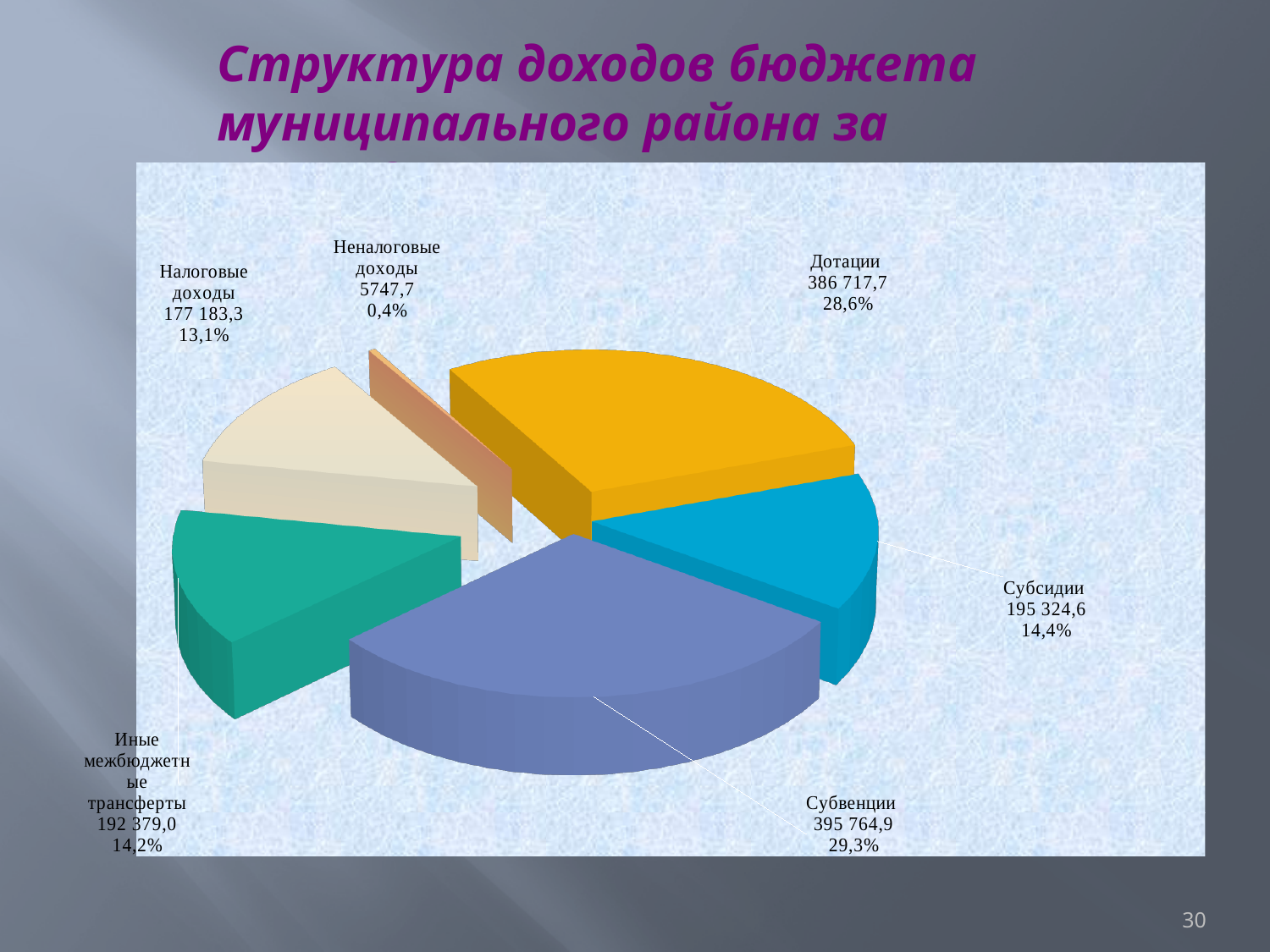
How many slices does the pie chart have? 6 What share of the pie does Субсидии represent? 14,4% Which category has the smallest share of the pie? Неналоговые доходы What kind of chart is shown on the slide? pie chart What is the value shown for Неналоговые доходы? 5747,7 What is the value shown for Субвенции? 395 764,9 What share of the pie does Иные межбюджетные трансферты represent? 14,2% What share of the pie does Налоговые доходы represent? 13,1% What is the value shown for Дотации? 386 717,7 Which category has the largest share of the pie? Субвенции What is the difference in percentage share between Субвенции and Дотации? 0,7% Which is larger, the value for Дотации or the value for Налоговые доходы? Дотации